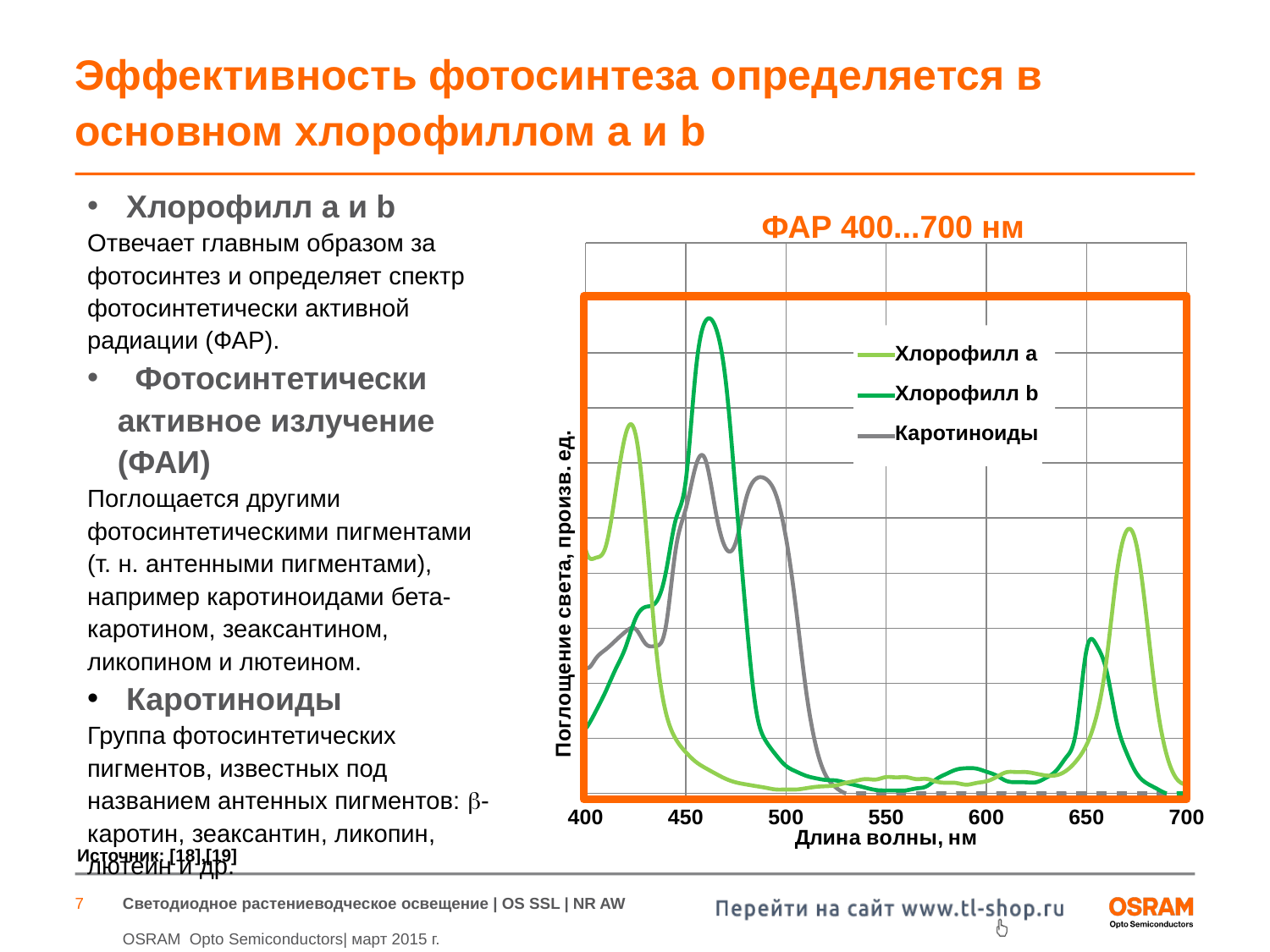
How many series does the chart legend list? 3 What is the range of wavelengths shown on the x axis of the chart? 400 to 700 Is the wavelength of the highest peak of Хлорофилл b greater or less than 500? less What is the title of the chart? ФАР 400...700 нм What kind of chart is shown on the slide? line chart How many labelled tick marks are on the x axis of the chart? 7 Is the wavelength of the red-region peak of Хлорофилл a greater or less than 650? greater What is the label of the y axis of the chart? Поглощение света, произв. ед. What is the label of the x axis of the chart? Длина волны, нм Which series has the highest absorption at 500 nm? Каротиноиды What are the three series named in the chart legend? Хлорофилл a, Хлорофилл b, Каротиноиды Which series reaches the highest absorption peak anywhere on the chart? Хлорофилл b